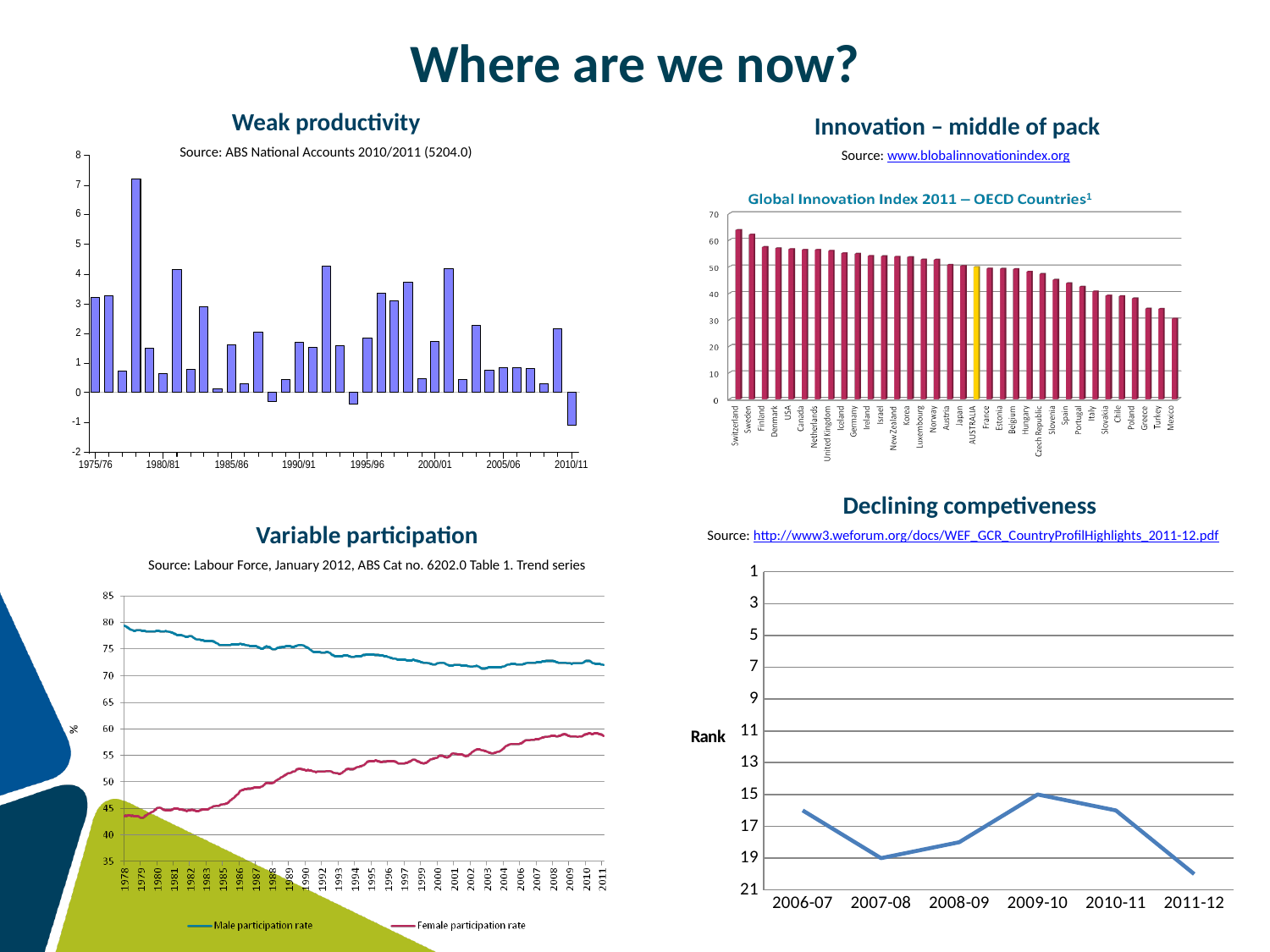
In the 'Innovation – middle of pack' chart, which country has the highest Global Innovation Index value? Switzerland What type of chart is the 'Declining competitiveness' chart? line chart What type of chart is the 'Weak productivity' chart? bar chart In the 'Innovation – middle of pack' chart, which country has the lowest Global Innovation Index value? Mexico In the 'Declining competitiveness' chart, which year has the worst (highest-numbered) rank? 2011-12 In the 'Variable participation' chart, does the male participation rate rise or fall from 1978 to 2011? fall In the 'Innovation – middle of pack' chart, which country's bar is highlighted in yellow? AUSTRALIA How many years are plotted in the 'Declining competitiveness' chart? 6 In the 'Innovation – middle of pack' chart, is the value for Switzerland greater or less than 60? greater How many series does the legend of the 'Variable participation' chart list? 2 In the 'Declining competitiveness' chart, what is the rank for 2009-10? 15 In the 'Variable participation' chart, is the female participation rate in 2011 greater or less than 60? less